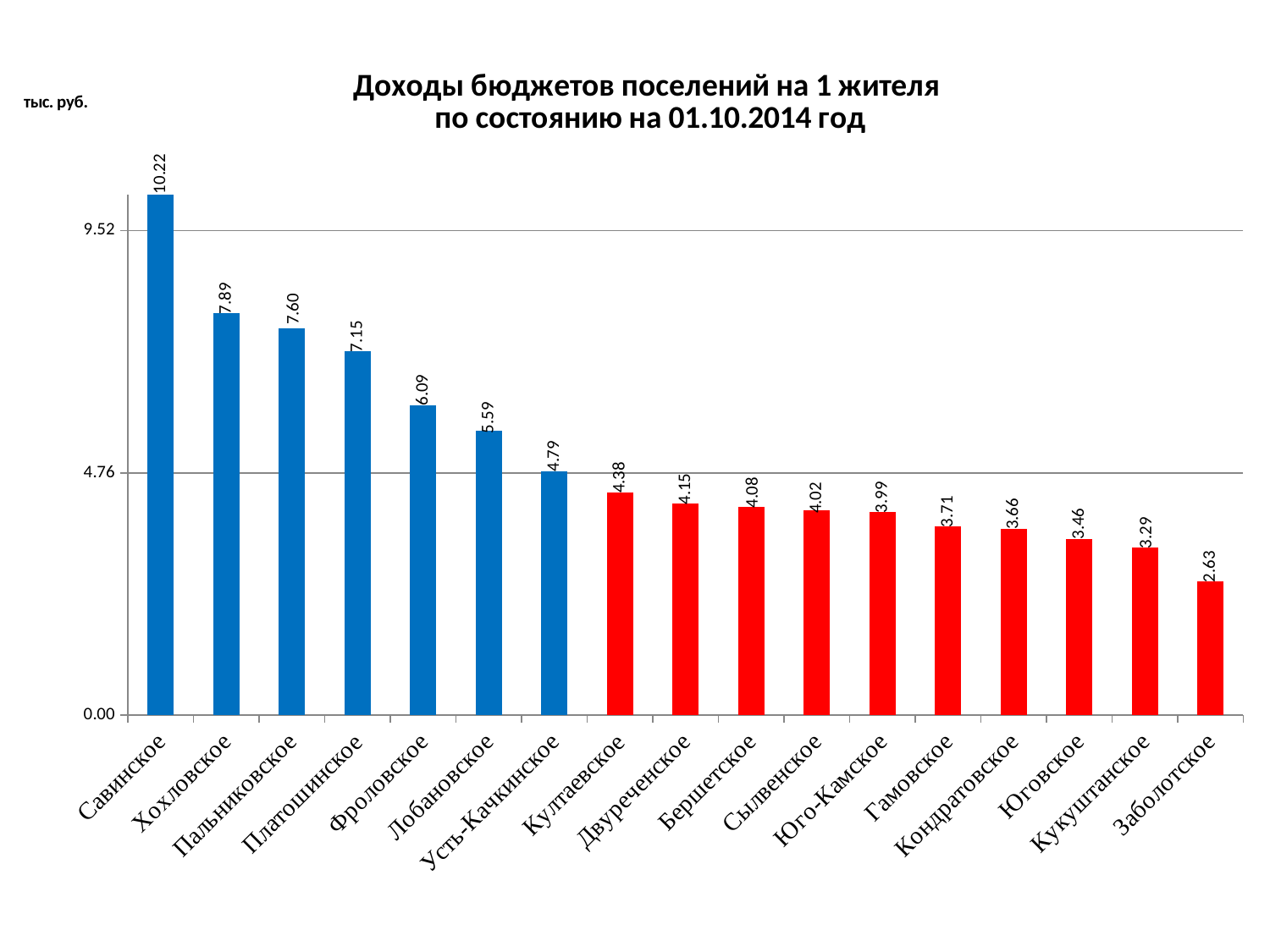
What is the value for Фроловское? 6.09 What is the value for Савинское? 10.22 Which is larger, the value for Платошинское or the value for Лобановское? Платошинское What is the value for Кондратовское? 3.66 Which settlement has the lowest value? Заболотское Is the value for Усть-Качкинское greater or less than 4.76? greater What kind of chart is shown on the slide? bar chart What is the difference between the values for Савинское and Заболотское? 7.59 What unit is indicated for the values on the chart? тыс. руб. How many settlements are shown on the chart? 17 Which settlement has the highest value? Савинское What is the difference between the values for Хохловское and Пальниковское? 0.29